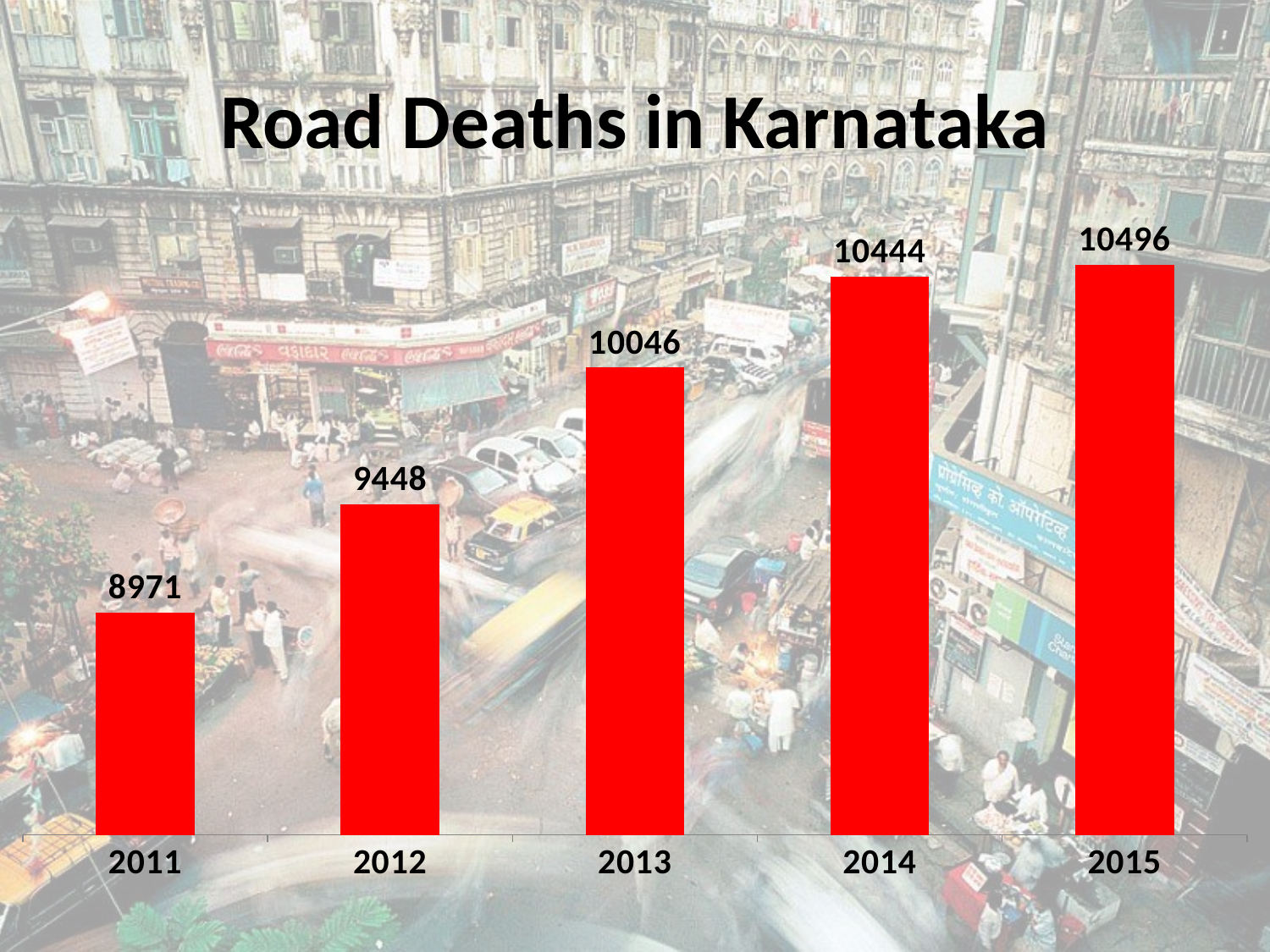
What is the number of road deaths in Karnataka in 2013? 10046 Which year has the highest number of road deaths? 2015 What is the difference in road deaths between 2014 and 2013? 398 What is the number of road deaths in Karnataka in 2011? 8971 Which year has the lowest number of road deaths? 2011 What kind of chart is shown on the slide? Bar chart What is the difference in road deaths between 2012 and 2011? 477 What is the number of road deaths in Karnataka in 2015? 10496 Do road deaths rise or fall from 2011 to 2015? Rise What is the title of the chart? Road Deaths in Karnataka Which year had more road deaths, 2012 or 2013? 2013 How many years are shown on the chart? 5